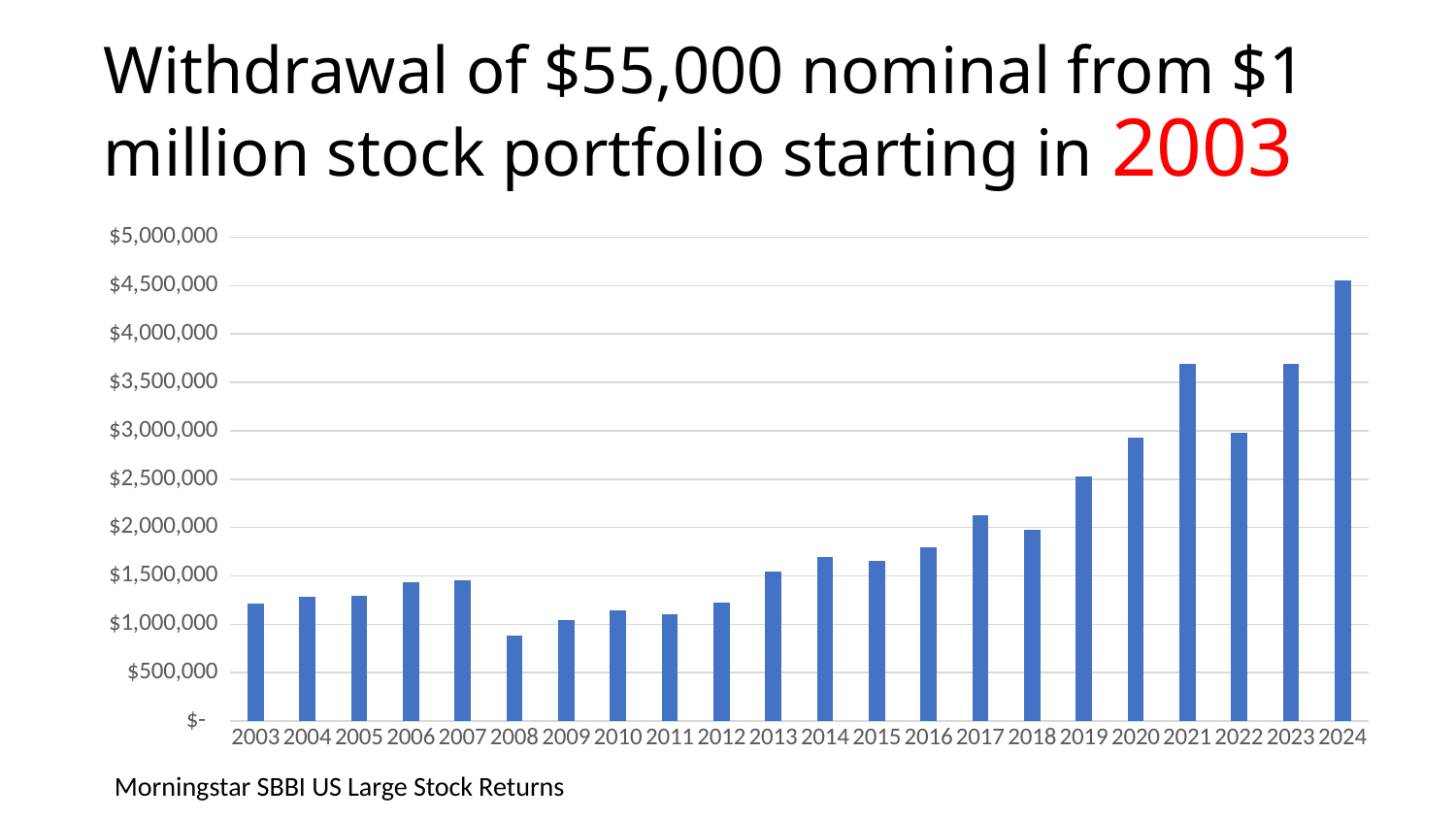
What kind of chart is shown on the slide? Bar chart What data source is cited below the chart? Morningstar SBBI US Large Stock Returns Which year has the highest portfolio value? 2024 Is the value for 2017 greater or less than $2,000,000? greater Is the value for 2008 greater or less than $1,000,000? less How many years are plotted on the x axis? 22 Which year has the lowest portfolio value? 2008 Which is larger, the value for 2007 or the value for 2009? 2007 Which is larger, the value for 2021 or the value for 2022? 2021